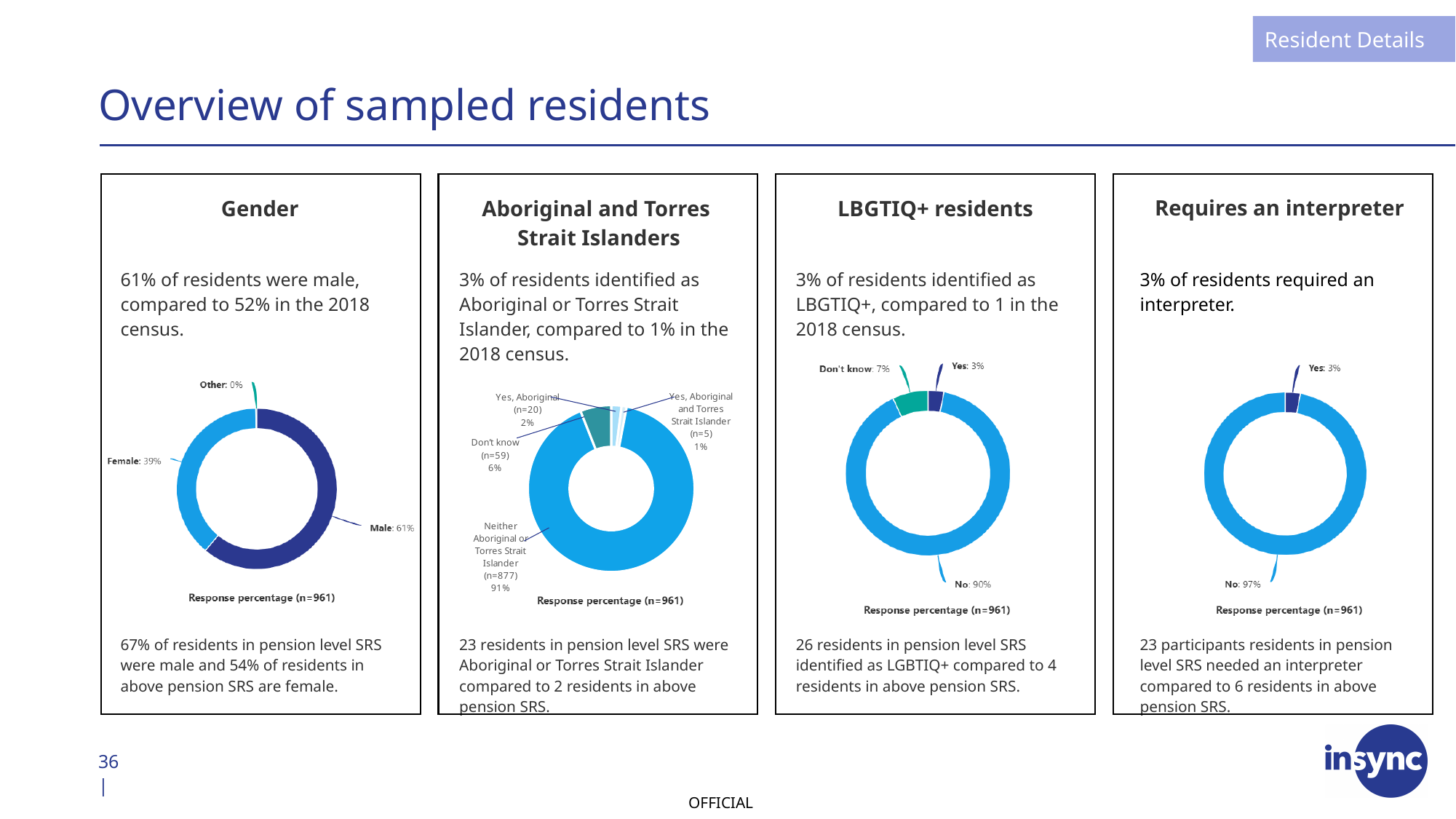
In the Requires an interpreter chart, which is larger, the 'Yes' share or the 'No' share? No How many categories are shown in the Aboriginal and Torres Strait Islanders chart? 4 In the Gender chart, what is the difference between the Male and Female percentages? 22% In the Gender chart, what percentage of residents were male? 61% In the Gender chart, what percentage of residents were female? 39% In the Requires an interpreter chart, what percentage of residents answered 'No'? 97% In the Aboriginal and Torres Strait Islanders chart, how many residents answered 'Don't know'? 59 In the Aboriginal and Torres Strait Islanders chart, what percentage of residents answered 'Neither Aboriginal or Torres Strait Islander'? 91% In the LBGTIQ+ residents chart, which category has the largest share? No What type of chart is used in the Gender panel? Donut (pie) chart In the LBGTIQ+ residents chart, what percentage of residents answered 'Don't know'? 7% In the Aboriginal and Torres Strait Islanders chart, which category has the smallest share? Yes, Aboriginal and Torres Strait Islander